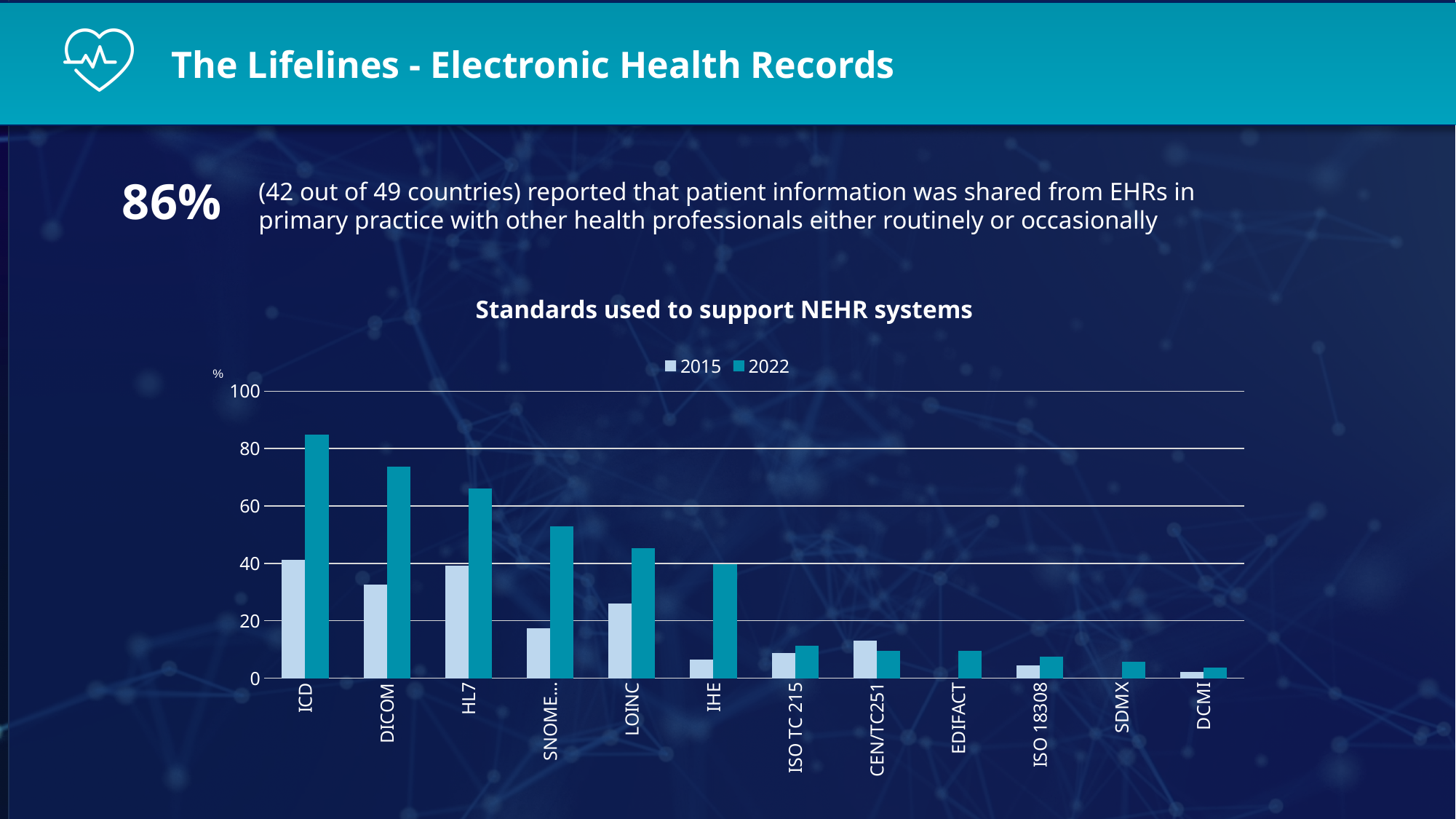
Is the 2022 value for DICOM greater or less than 60? greater What kind of chart is shown on the slide? bar chart Do the 2022 values generally rise or fall moving from left to right along the x axis? fall Which standard has the lowest value for 2022? DCMI For IHE, which year has the larger value, 2015 or 2022? 2022 Is the 2022 value for SNOME... greater or less than 40? greater How many standards (categories) are shown on the x axis? 12 Is the 2022 value for ICD greater or less than 80? greater What is the title of the chart? Standards used to support NEHR systems How many series does the legend list? 2 Which standard has the highest value for 2022? ICD